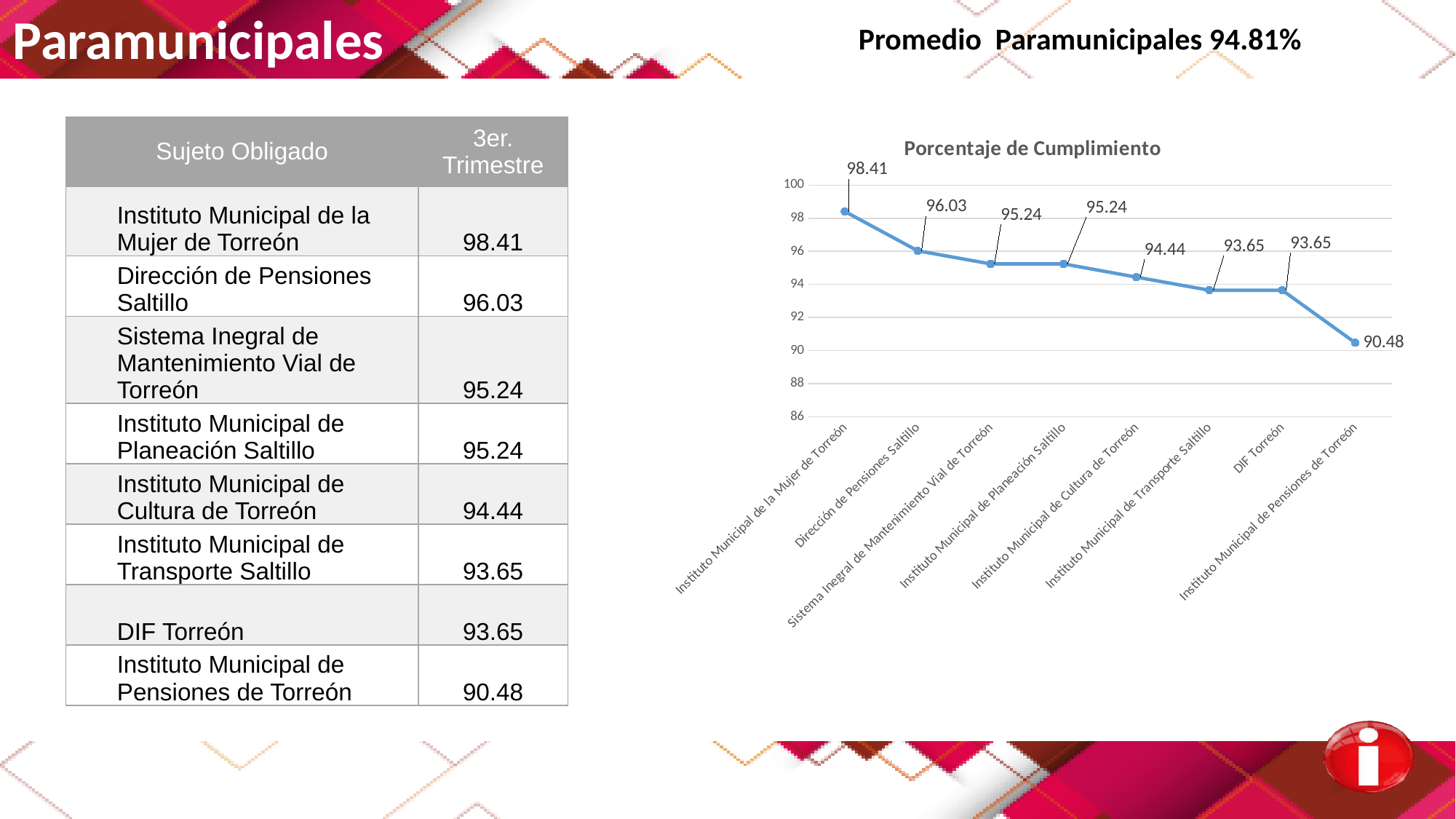
Which category has the highest value? Instituto Municipal de la Mujer de Torreón What is the title of the chart? Porcentaje de Cumplimiento What is the value for Instituto Municipal de Cultura de Torreón? 94.44 What is the value for Dirección de Pensiones Saltillo? 96.03 What is the value for Instituto Municipal de la Mujer de Torreón? 98.41 What type of chart is shown on the slide? line chart Which is larger, the value for Dirección de Pensiones Saltillo or the value for Instituto Municipal de Transporte Saltillo? Dirección de Pensiones Saltillo How many categories are plotted on the chart? 8 What is the value for DIF Torreón? 93.65 Which category has the lowest value? Instituto Municipal de Pensiones de Torreón Do the values rise or fall from left to right along the x axis? fall What is the difference between the values for Instituto Municipal de la Mujer de Torreón and Instituto Municipal de Pensiones de Torreón? 7.93